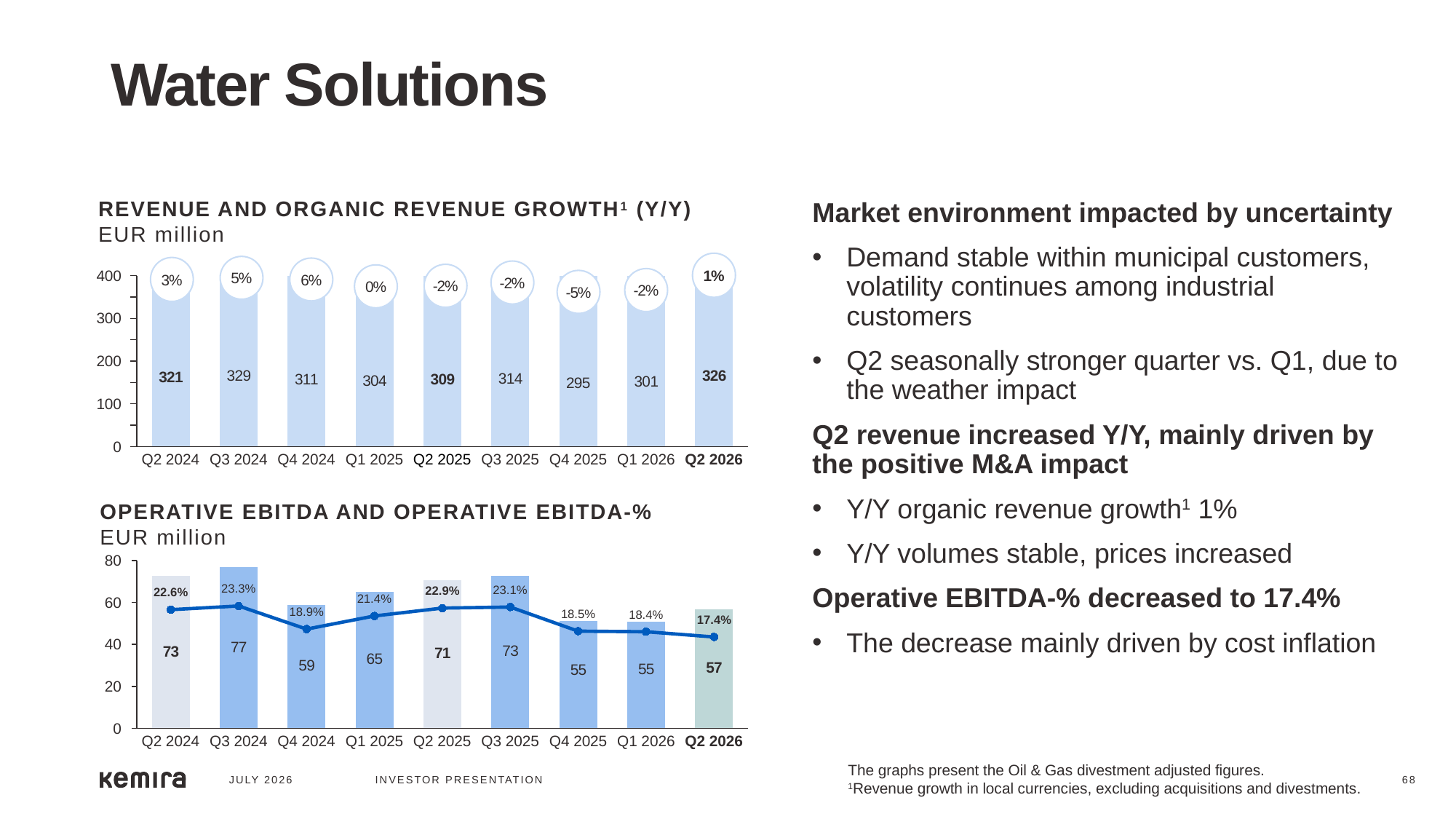
In the 'Revenue and organic revenue growth' chart, which quarter has the highest revenue? Q3 2024 In the 'Operative EBITDA and operative EBITDA-%' chart, is the operative EBITDA for Q1 2025 larger than for Q4 2024? Yes In the 'Revenue and organic revenue growth' chart, which quarter has the lowest revenue? Q4 2025 In the 'Revenue and organic revenue growth' chart, how many quarters are shown? 9 In the 'Revenue and organic revenue growth' chart, what is the organic revenue growth for Q4 2025? -5% In the 'Operative EBITDA and operative EBITDA-%' chart, what is the difference in operative EBITDA between Q2 2025 and Q2 2026? 14 In the 'Operative EBITDA and operative EBITDA-%' chart, what is the operative EBITDA-% for Q3 2024? 23.3% In the 'Revenue and organic revenue growth' chart, what is the difference in revenue between Q2 2026 and Q2 2025? 17 In the 'Revenue and organic revenue growth' chart, what is the revenue for Q2 2026? 326 In the 'Operative EBITDA and operative EBITDA-%' chart, which quarter has the highest operative EBITDA? Q3 2024 What type of chart is the 'Revenue and organic revenue growth' chart? Bar chart In the 'Operative EBITDA and operative EBITDA-%' chart, what is the operative EBITDA for Q2 2026? 57